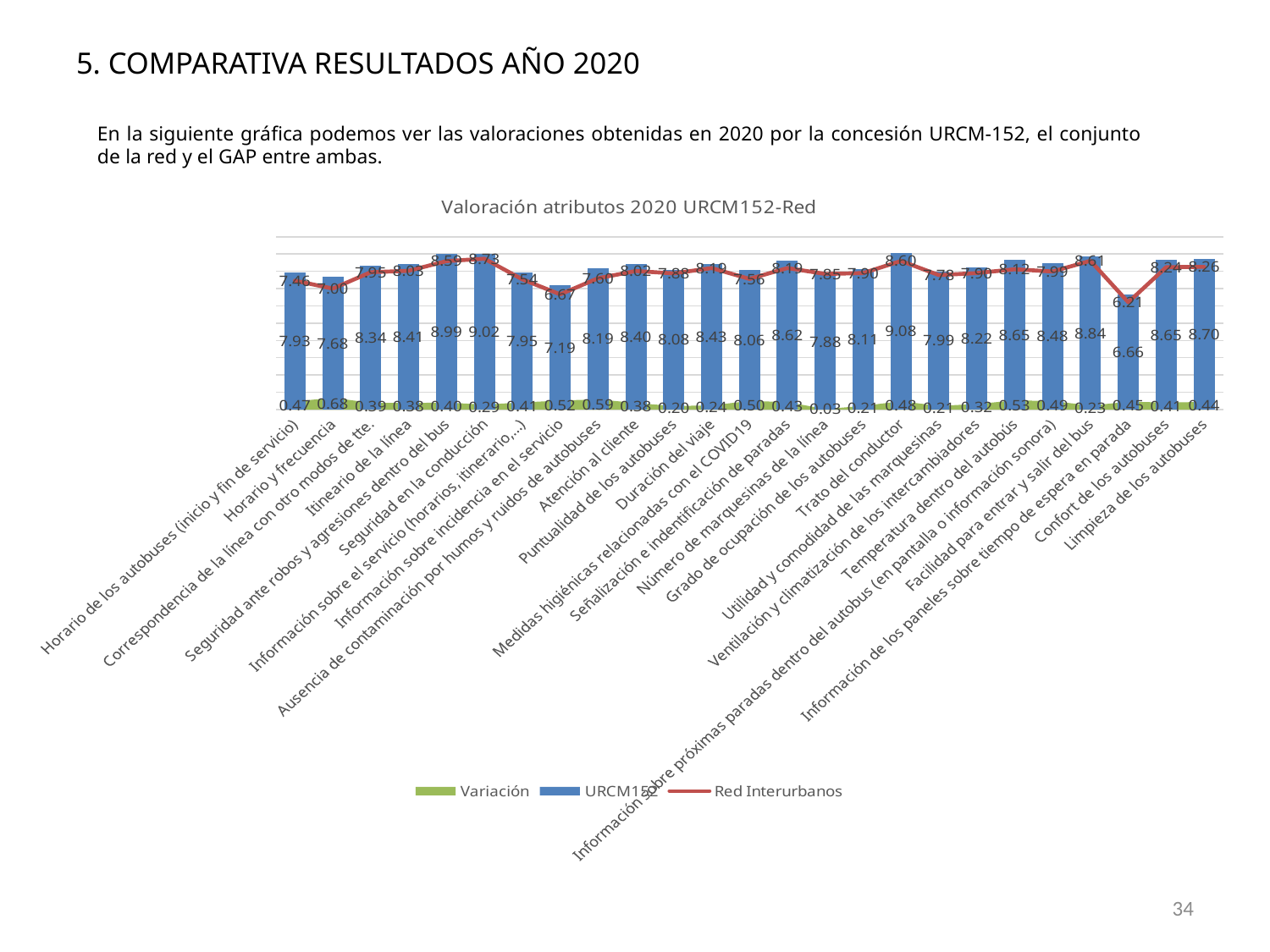
What is the title of the chart? Valoración atributos 2020 URCM152-Red Which attribute has the largest Variación value? Horario y frecuencia What kind of chart is shown on the slide? Combination chart with bars, a line and an area What is the Red Interurbanos value for 'Horario y frecuencia'? 7.00 What is the Variación value for 'Número de marquesinas de la línea'? 0.03 What is the URCM152 value for 'Trato del conductor'? 9.08 How many series does the legend list? 3 Which has a higher URCM152 value, 'Limpieza de los autobuses' or 'Confort de los autobuses'? Limpieza de los autobuses How many attributes are shown on the x axis of the chart? 25 Which attribute has the highest URCM152 value? Trato del conductor What is the difference between the URCM152 value and the Red Interurbanos value for 'Horario de los autobuses (inicio y fin de servicio)'? 0.47 Which attribute has the lowest URCM152 value? Información de los paneles sobre tiempo de espera en parada